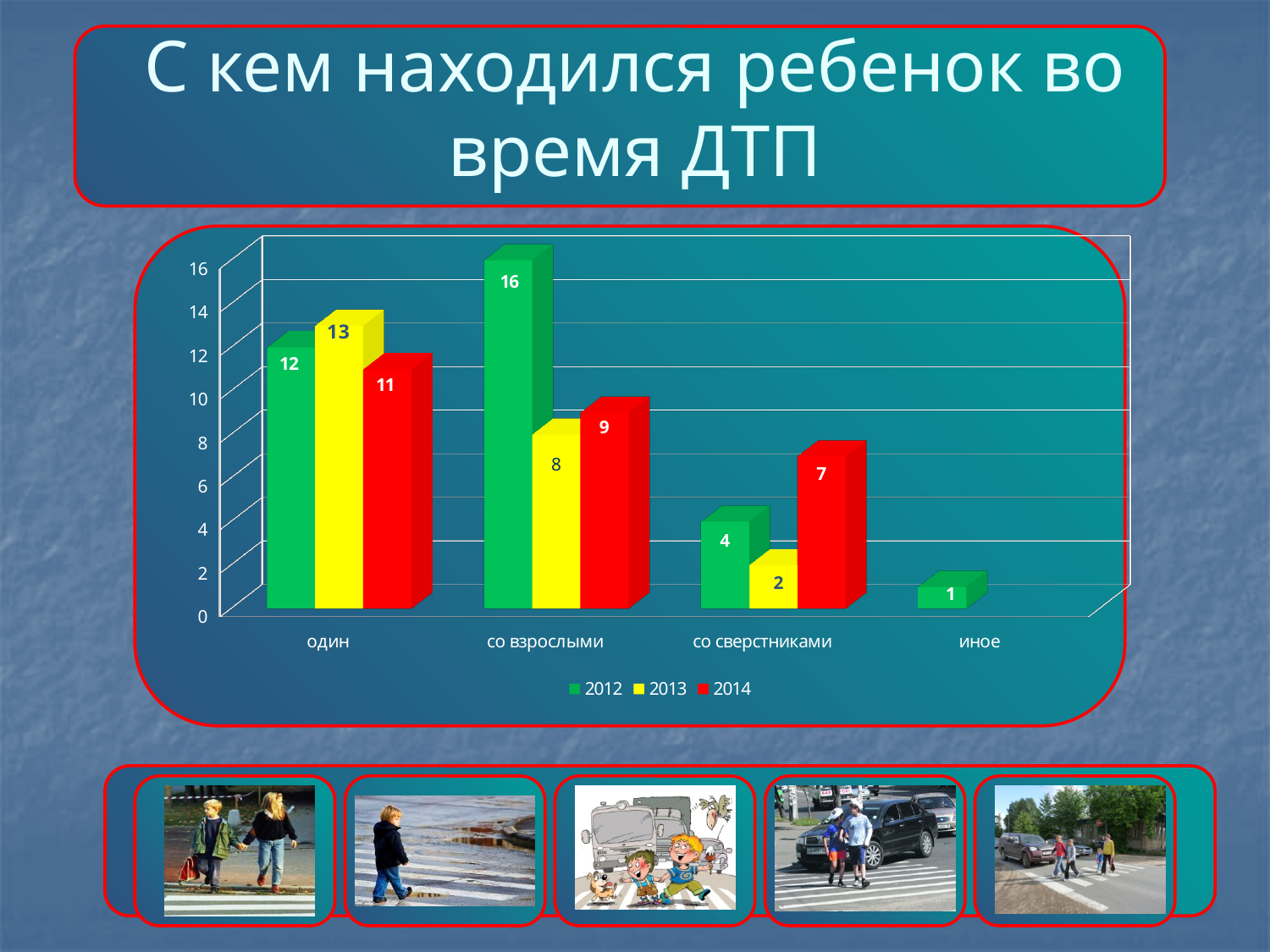
What kind of chart is shown on the slide? bar chart Which category has the highest value for the 2012 series? со взрослыми What is the value for 2012 in the "иное" category? 1 Which category has the lowest value for the 2013 series? со сверстниками How many categories are shown on the x axis? 4 What is the value for 2012 in the "со взрослыми" category? 16 How many series does the legend list? 3 Which is larger in the "один" category: the 2013 value or the 2014 value? 2013 What is the difference between the 2012 and 2013 values in the "со взрослыми" category? 8 What is the value for 2013 in the "один" category? 13 What is the value for 2014 in the "со сверстниками" category? 7 Which colour represents the 2014 series in the legend? red